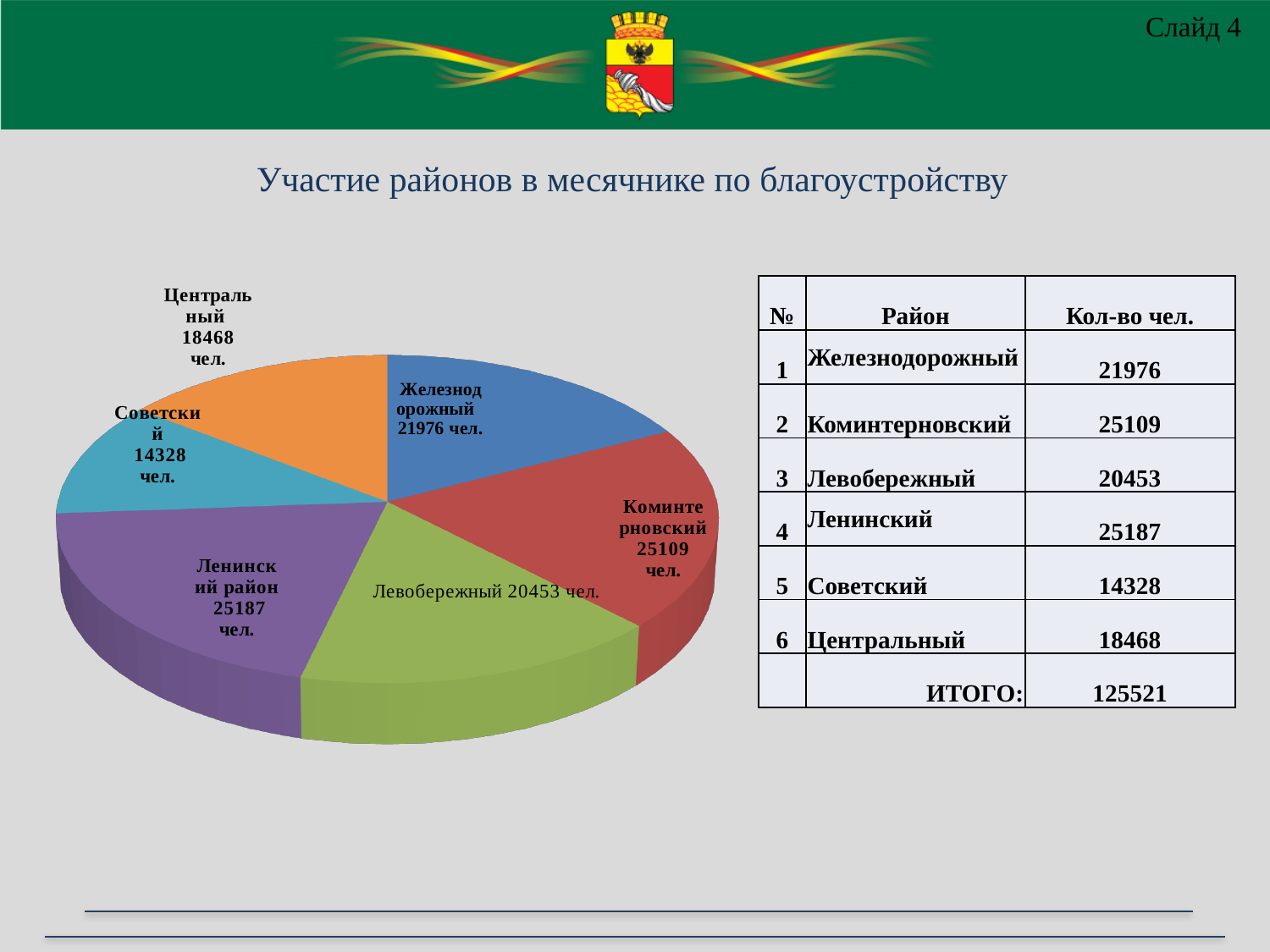
What is the value for Центральный in the chart? 18468 чел. What is the difference between the values for Ленинский and Коминтерновский? 78 How many people does the pie chart show for Советский? 14328 чел. Which district has the largest value in the pie chart? Ленинский How many districts are shown in the pie chart? 6 What is the title of the slide containing the chart? Участие районов в месячнике по благоустройству Which is larger, the value for Железнодорожный or the value for Левобережный? Железнодорожный What kind of chart is shown on the slide? Pie chart What is the difference between the values for Центральный and Советский? 4140 What is the value for Железнодорожный in the pie chart? 21976 чел. Which district has the smallest slice in the pie chart? Советский What is the value shown for Левобережный? 20453 чел.